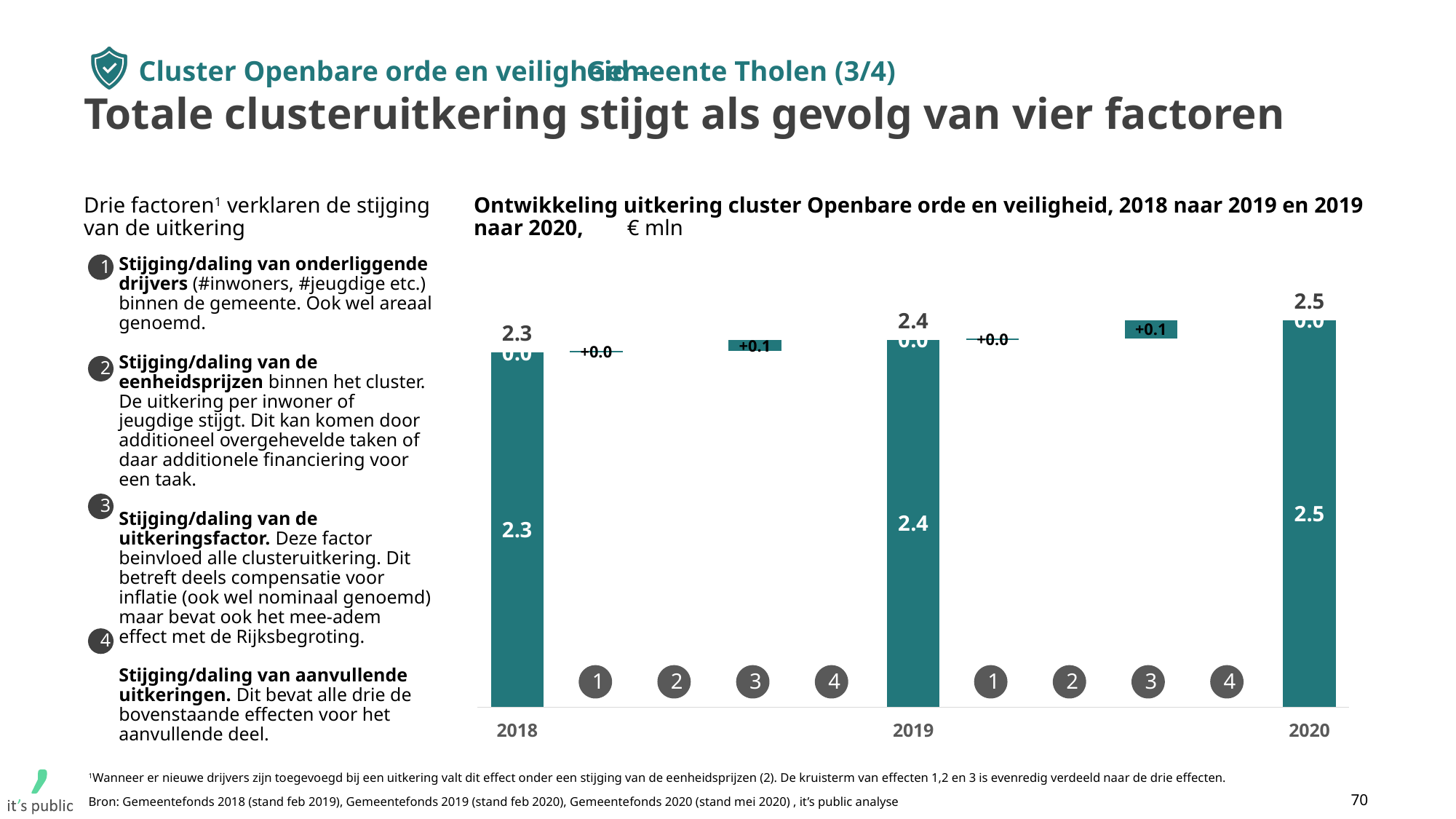
In what unit are the values on the chart expressed? € mln What is the total cluster payment shown for 2020? 2.5 Which year has the highest total cluster payment? 2020 What is the total cluster payment shown for 2019? 2.4 Do the total cluster payments rise or fall from 2018 to 2020? rise How many years are shown with total bars on the chart? 3 Is the total for 2019 larger or smaller than the total for 2018? larger What is the total cluster payment shown for 2018? 2.3 What is the difference between the 2020 total and the 2018 total? 0.2 Which year has the lowest total cluster payment? 2018 What is the value of factor 3 between 2019 and 2020? +0.1 What is the value of factor 1 between 2018 and 2019? +0.0